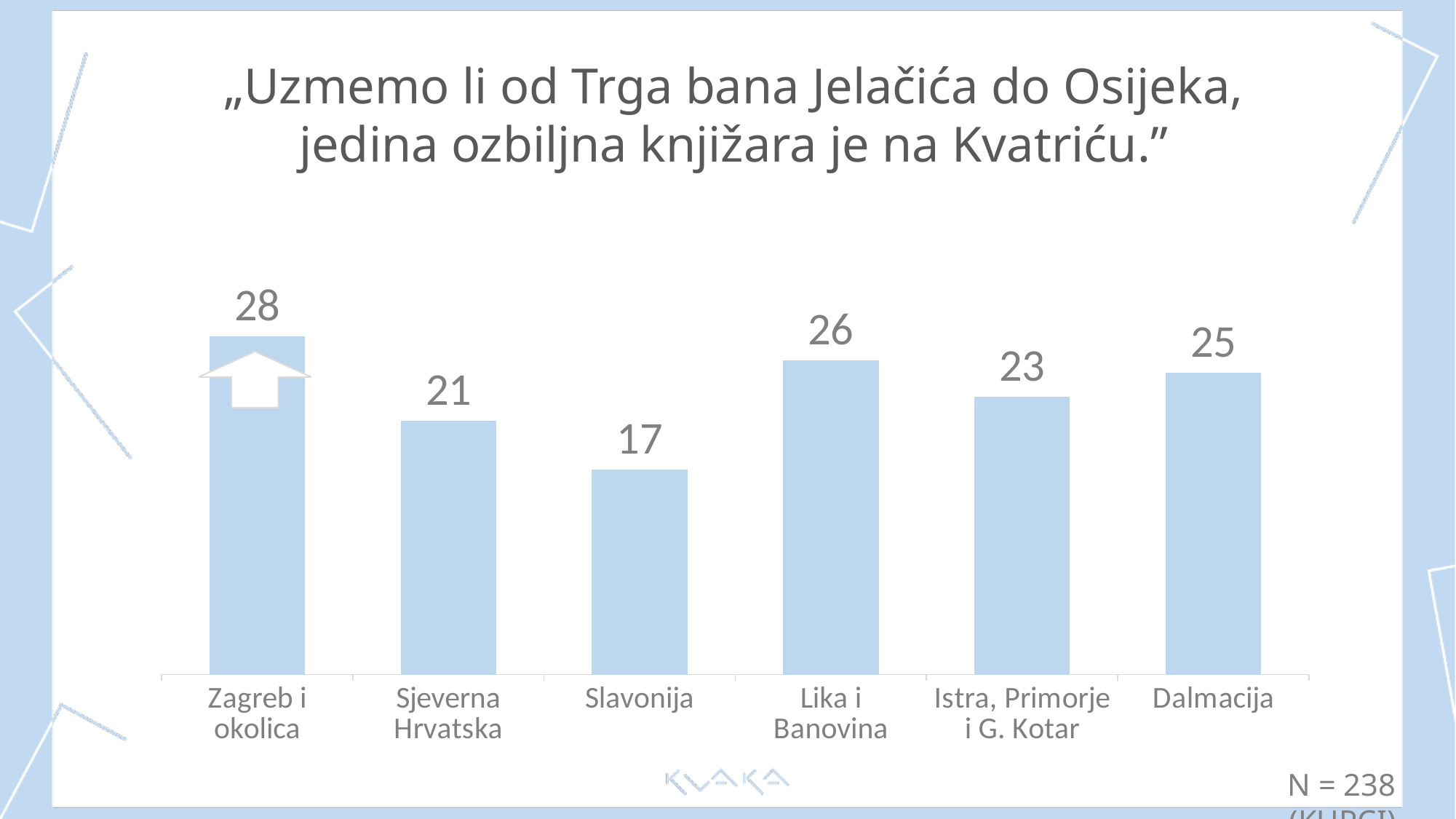
Which category has the lowest value? Slavonija What is the value for Istra, Primorje i G. Kotar? 23 What is the difference between the values for Zagreb i okolica and Slavonija? 11 What is the difference between the values for Lika i Banovina and Sjeverna Hrvatska? 5 Which category has the highest value? Zagreb i okolica What kind of chart is shown on the slide? bar chart How many categories are shown on the chart? 6 Which is larger, the value for Lika i Banovina or the value for Dalmacija? Lika i Banovina What sample size (N) is stated on the slide? N = 238 What is the value for Dalmacija? 25 What is the value for Zagreb i okolica? 28 What is the value for Slavonija? 17